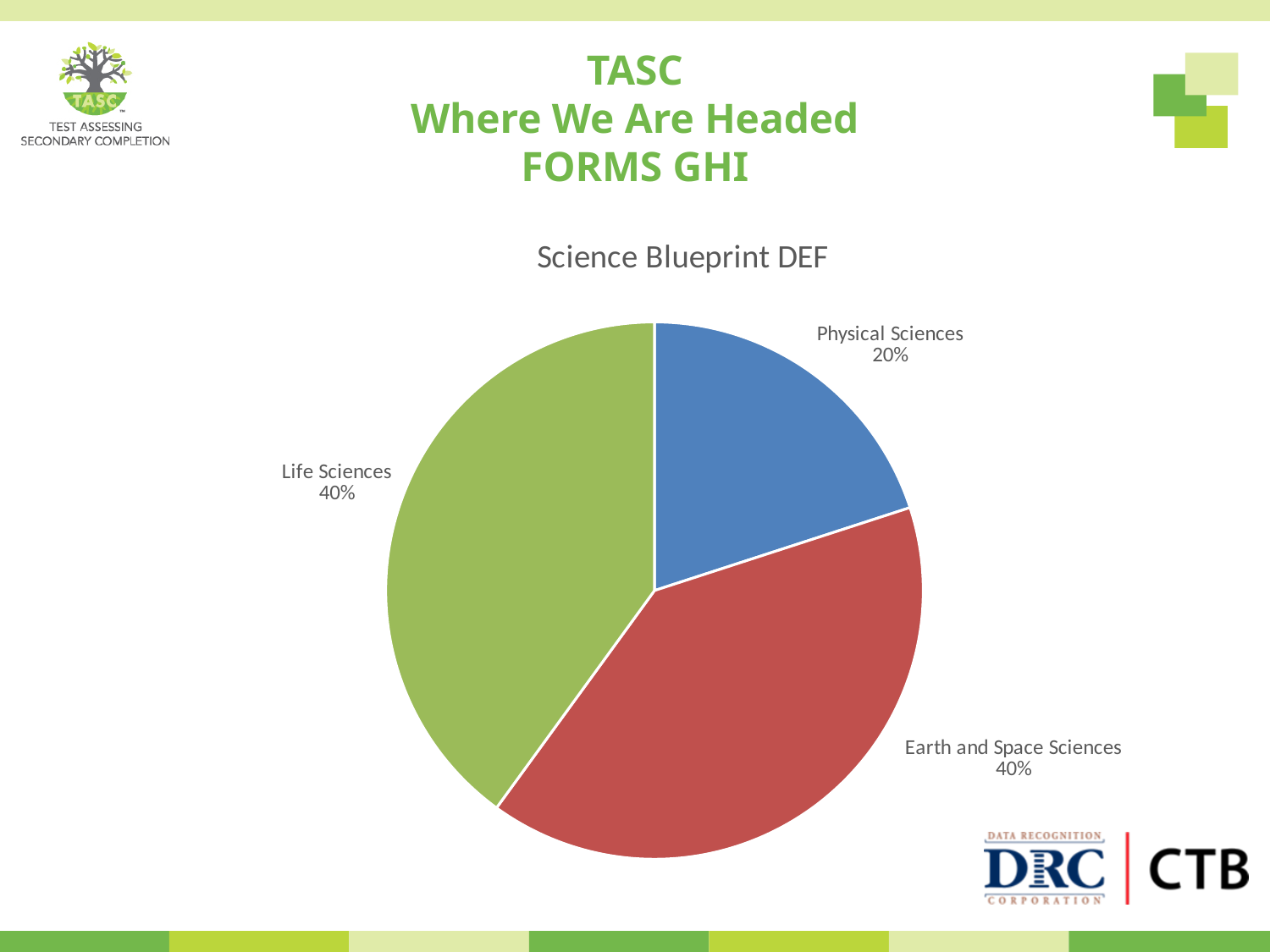
What share of the pie does Life Sciences represent? 40% What is the title of the chart? Science Blueprint DEF What colour is the Life Sciences slice? Green What is the combined share of Life Sciences and Earth and Space Sciences? 80% What share of the pie does Physical Sciences represent? 20% How many categories are shown in the pie chart? 3 What kind of chart is shown on the slide? Pie chart What share of the pie does Earth and Space Sciences represent? 40% What is the difference between the Life Sciences share and the Physical Sciences share? 20% Which category has the smallest slice of the pie? Physical Sciences Which is larger, the Earth and Space Sciences slice or the Physical Sciences slice? Earth and Space Sciences